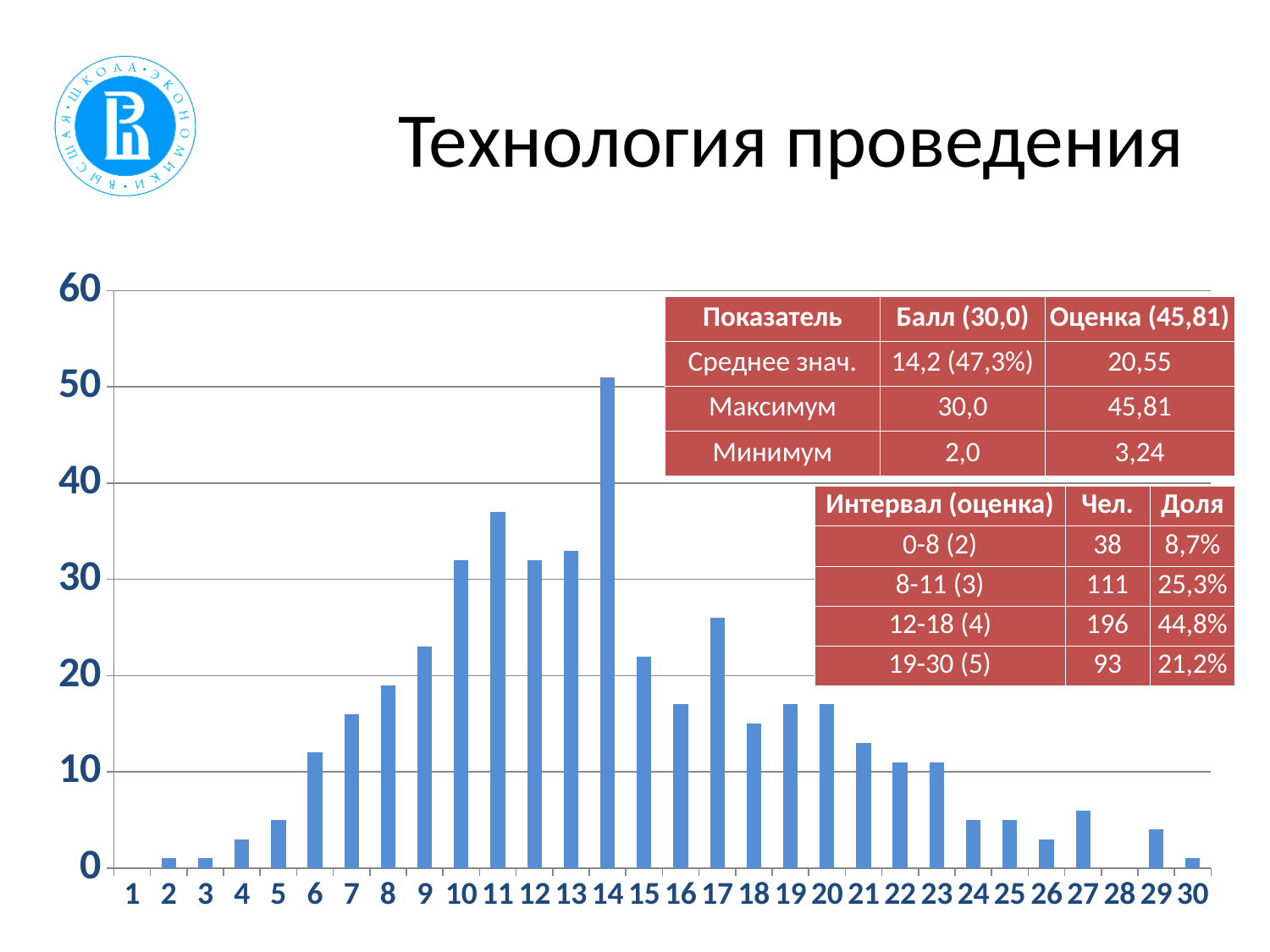
What kind of chart is shown on the slide? bar chart Is the value for category 14 greater or less than 40? greater Is the value for category 27 greater or less than 10? less Do the values generally rise or fall along the x axis from category 14 to category 30? fall How many categories are shown along the x axis of the chart? 30 Is the value for category 11 greater or less than 30? greater What is the title of the slide containing the chart? Технология проведения Which category has the highest bar in the chart? 14 Which is larger, the value for category 9 or the value for category 6? 9 Which is larger, the value for category 20 or the value for category 21? 20